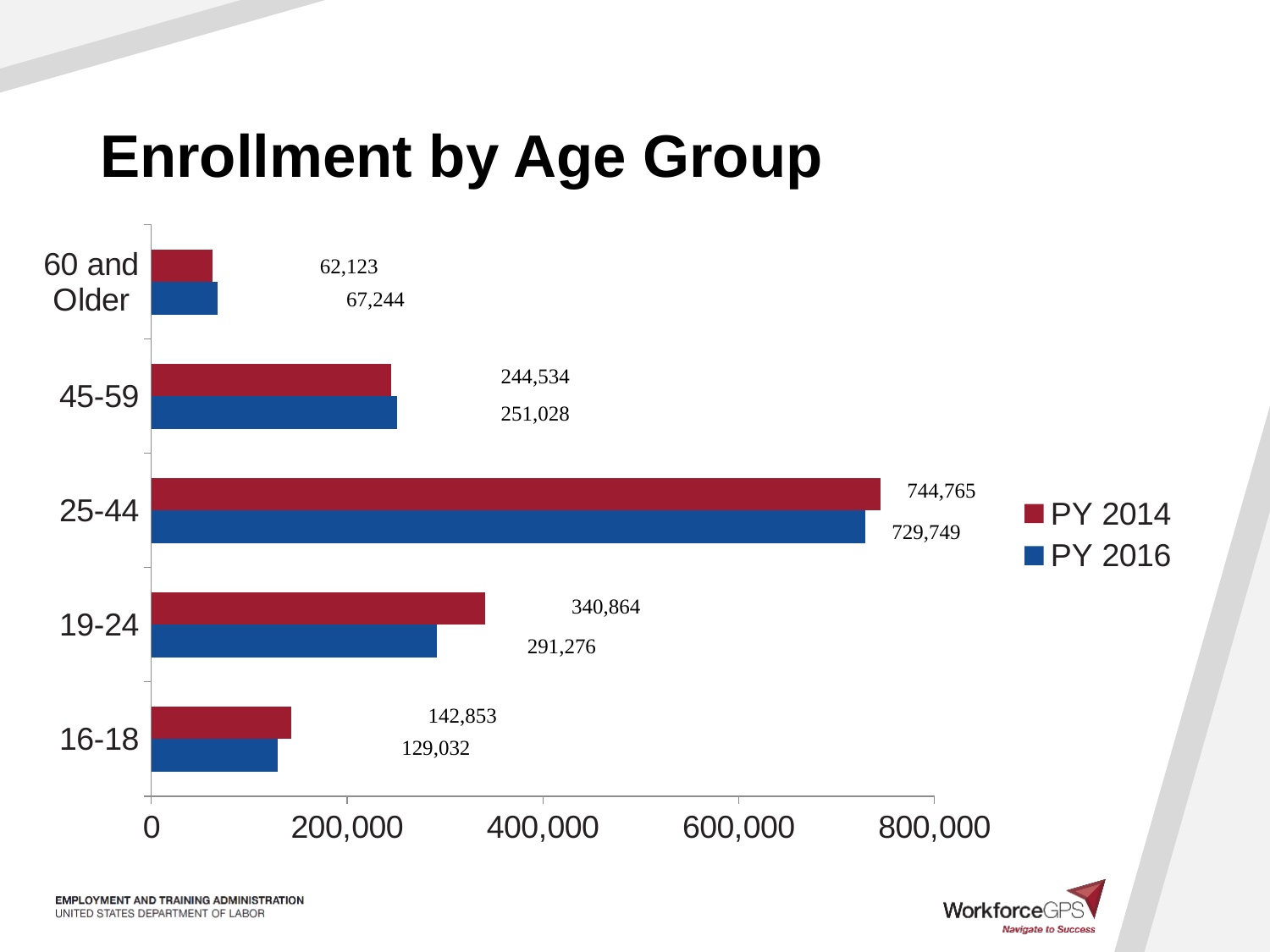
What is the difference between PY 2014 and PY 2016 enrollment for the 19-24 age group? 49,588 Is the PY 2014 enrollment for the 19-24 age group greater or less than 400,000? less Which age group has the lowest PY 2016 enrollment? 60 and Older How many series does the legend list? 2 Which age group has the highest PY 2014 enrollment? 25-44 What type of chart is shown on the slide? Bar chart What is the PY 2016 enrollment for the 16-18 age group? 129,032 What is the PY 2014 enrollment for the 25-44 age group? 744,765 How many age groups are shown in the chart? 5 What is the difference between PY 2014 and PY 2016 enrollment for the 25-44 age group? 15,016 For the 45-59 age group, which is larger: PY 2014 or PY 2016 enrollment? PY 2016 What is the PY 2016 enrollment for the 60 and Older age group? 67,244